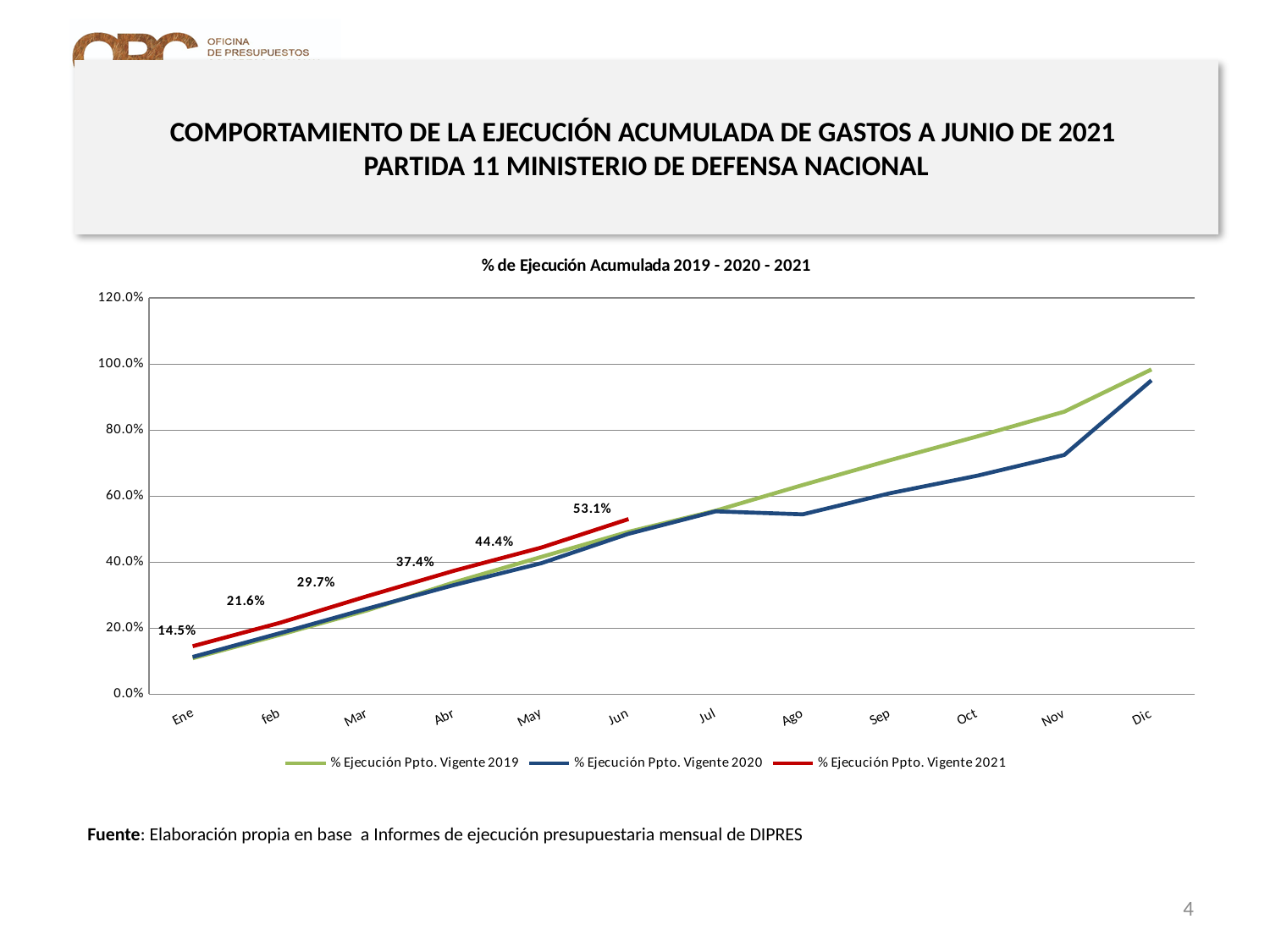
In Nov, which series is larger: % Ejecución Ppto. Vigente 2019 or % Ejecución Ppto. Vigente 2020? % Ejecución Ppto. Vigente 2019 By how many percentage points did % Ejecución Ppto. Vigente 2021 increase from Ene to Jun? 38.6% Does the % Ejecución Ppto. Vigente 2021 line rise or fall from Ene to Jun? Rises Is the value for % Ejecución Ppto. Vigente 2020 in Dic greater or less than 80.0%? greater How many series does the legend list? 3 What is the value of % Ejecución Ppto. Vigente 2021 in Jun? 53.1% How many months are shown on the x axis? 12 What is the difference between the 2021 values for May and Abr? 7.0% What is the value of % Ejecución Ppto. Vigente 2021 in Ene? 14.5% What kind of chart is shown on the slide? Line chart What is the value of % Ejecución Ppto. Vigente 2021 in Abr? 37.4% What is the title of the chart? % de Ejecución Acumulada 2019 - 2020 - 2021